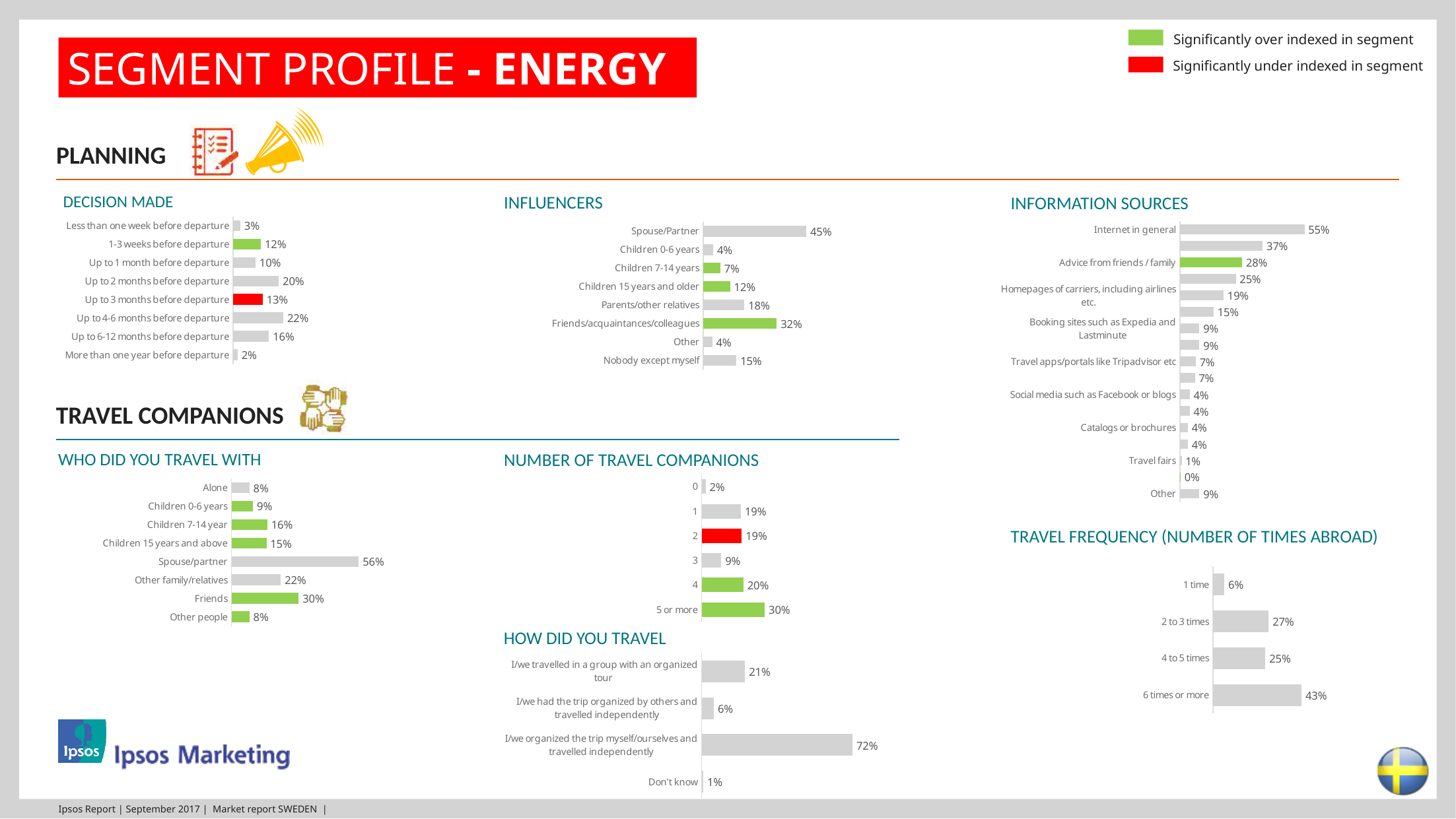
In the "WHO DID YOU TRAVEL WITH" chart, how many categories are shown? 8 In the "INFLUENCERS" chart, what is the difference between Spouse/Partner and Friends/acquaintances/colleagues? 13% In the "DECISION MADE" chart, what is the value for "Up to 4-6 months before departure"? 22% In the "NUMBER OF TRAVEL COMPANIONS" chart, what is the value for "5 or more"? 30% In the "DECISION MADE" chart, which category has the lowest value? More than one year before departure In the "INFORMATION SOURCES" chart, what is the value for "Internet in general"? 55% In the "INFORMATION SOURCES" chart, what is the value for "Advice from friends / family"? 28% In the "TRAVEL FREQUENCY (NUMBER OF TIMES ABROAD)" chart, what is the difference between "6 times or more" and "1 time"? 37% In the "INFLUENCERS" chart, which category has the highest value? Spouse/Partner In the "WHO DID YOU TRAVEL WITH" chart, which is larger, Friends or Other family/relatives? Friends What type of chart is the "TRAVEL FREQUENCY (NUMBER OF TIMES ABROAD)" chart? Bar chart In the "HOW DID YOU TRAVEL" chart, what is the value for "I/we organized the trip myself/ourselves and travelled independently"? 72%